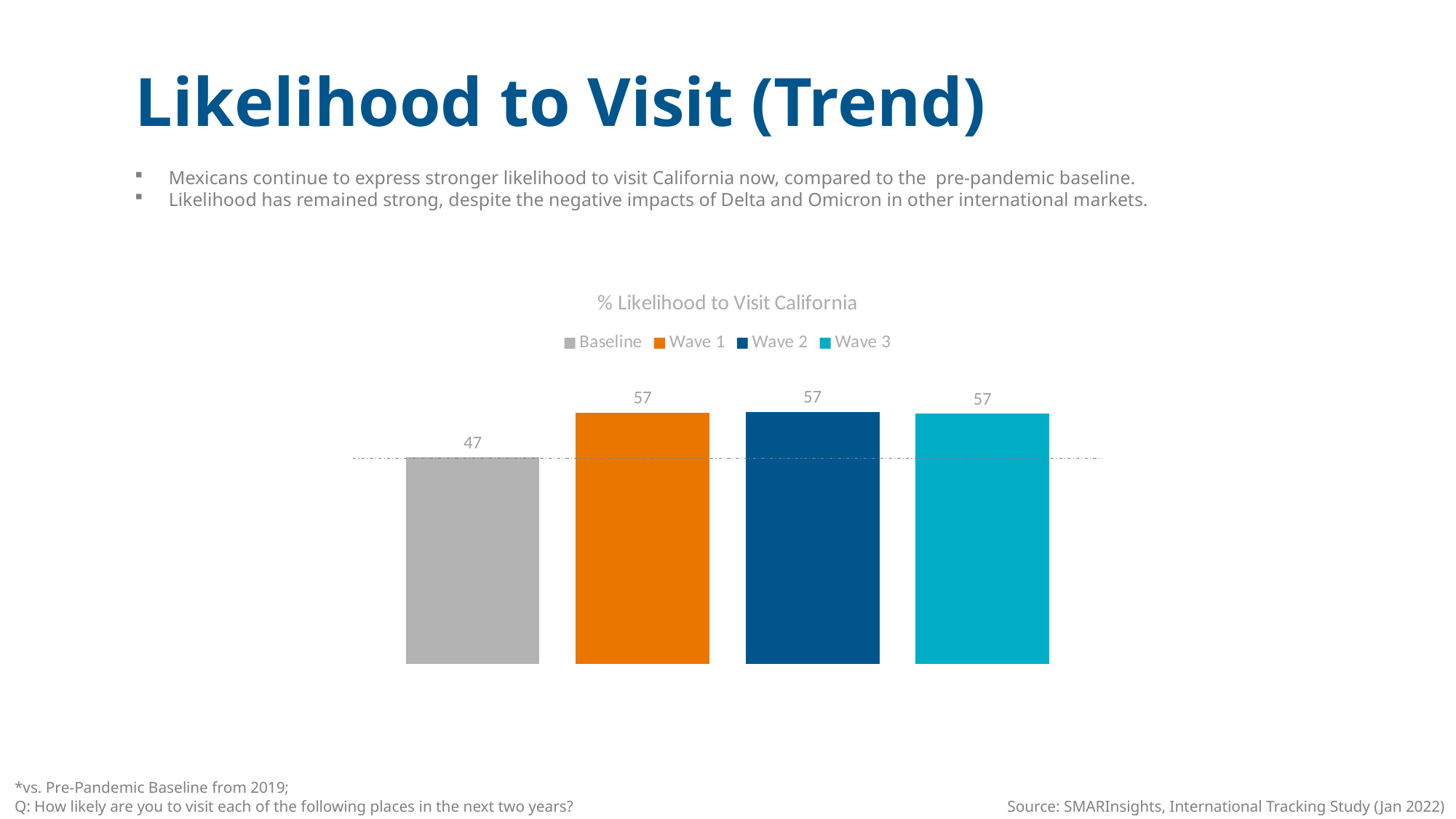
What is the title of the chart on the slide? % Likelihood to Visit California Which is larger, the Baseline value or the Wave 3 value? Wave 3 What is the value for Baseline in the % Likelihood to Visit California chart? 47 How many bars are plotted in the % Likelihood to Visit California chart? 4 What is the difference between the Wave 1 value and the Baseline value? 10 How many series does the legend list in the % Likelihood to Visit California chart? 4 What is the value for Wave 1 in the % Likelihood to Visit California chart? 57 Do the values rise or fall from Baseline to Wave 1? Rise Which series has the lowest value in the % Likelihood to Visit California chart? Baseline What kind of chart is shown on the slide? Bar chart What is the value for Wave 2 in the % Likelihood to Visit California chart? 57 What is the value for Wave 3 in the % Likelihood to Visit California chart? 57